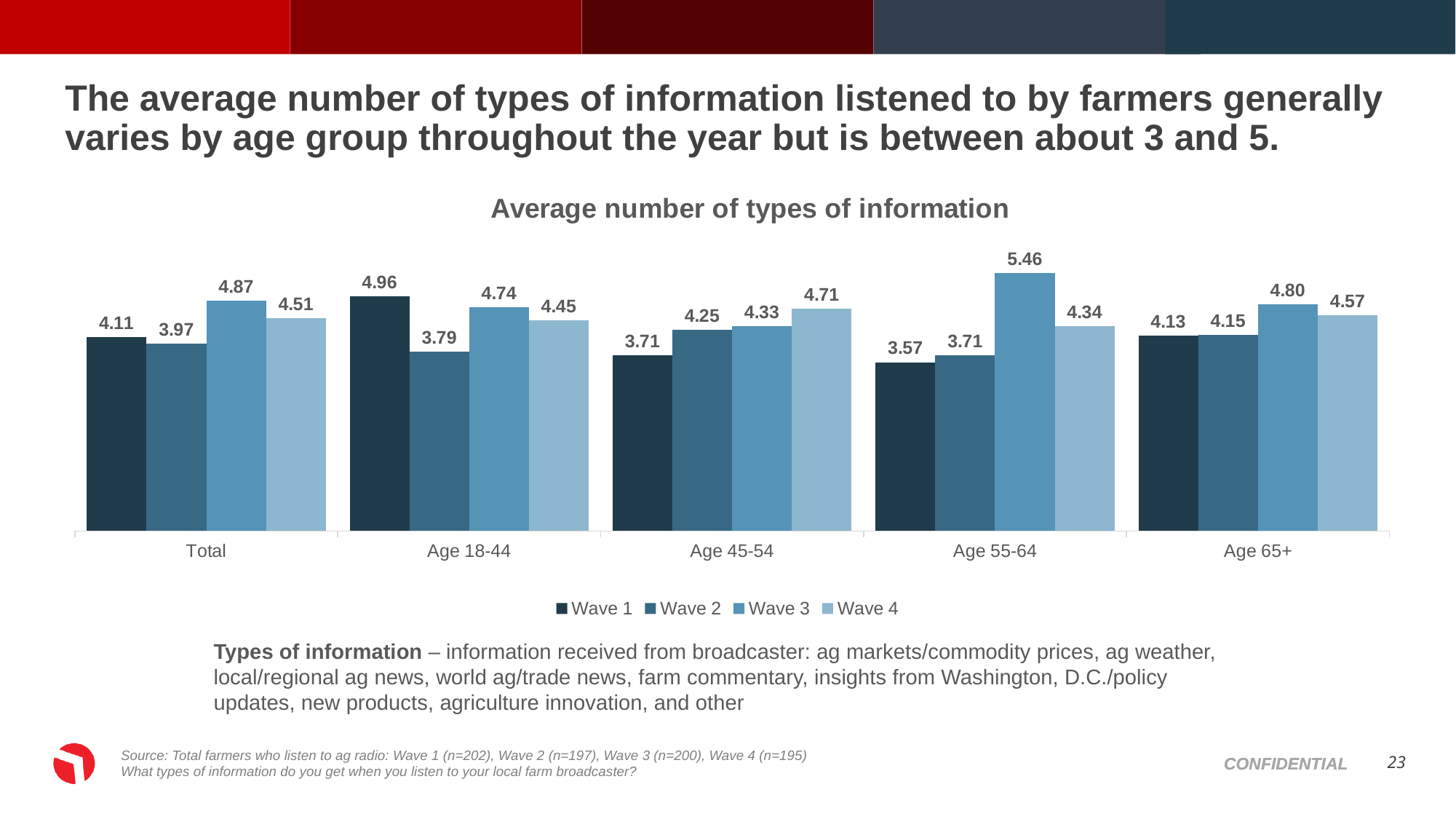
Which category has the lowest Wave 2 value? Age 55-64 What is the title of the chart? Average number of types of information What kind of chart is shown on the slide? Bar chart What is the Wave 3 value for Age 55-64? 5.46 What is the Wave 4 value for Age 45-54? 4.71 Which is larger for Age 18-44: the Wave 1 value or the Wave 3 value? Wave 1 How many series does the legend list? 4 Do the values for Age 65+ rise or fall from Wave 1 to Wave 3? Rise Which age group has the highest Wave 1 value? Age 18-44 How many categories are shown on the x axis? 5 What is the difference between the Wave 3 and Wave 1 values for Age 55-64? 1.89 What is the Wave 1 value for the Total category? 4.11